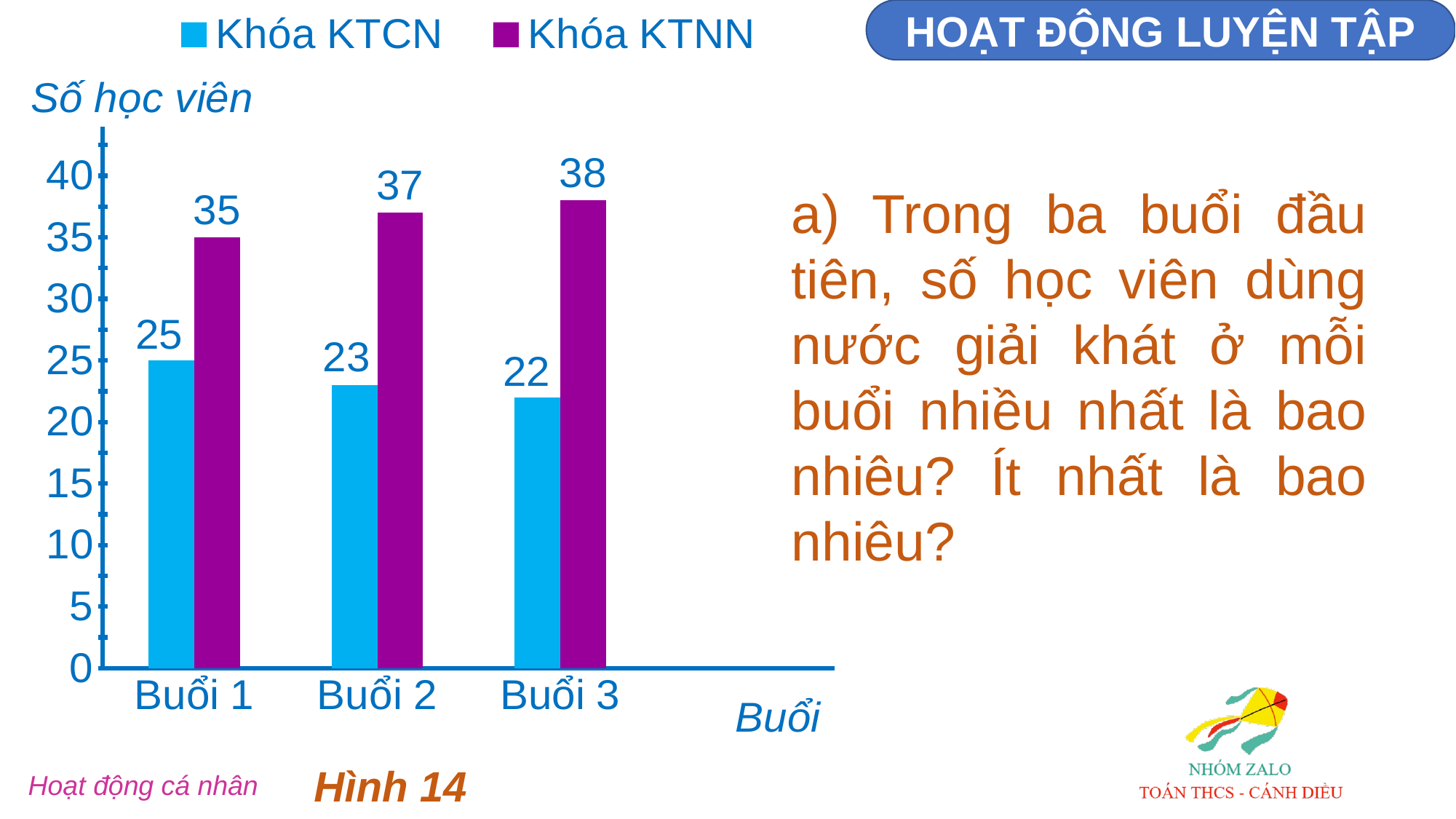
What is the label of the vertical axis? Số học viên What is the value for Khóa KTNN in Buổi 2? 37 What kind of chart is shown on the slide? bar chart Which is larger in Buổi 2: Khóa KTCN or Khóa KTNN? Khóa KTNN What is the value for Khóa KTCN in Buổi 3? 22 How many series does the legend list? 2 What is the value for Khóa KTCN in Buổi 1? 25 How many sessions (Buổi) are shown on the x axis? 3 Which session (Buổi) has the highest value for Khóa KTNN? Buổi 3 Which session (Buổi) has the lowest value for Khóa KTCN? Buổi 3 What is the difference between Khóa KTNN and Khóa KTCN in Buổi 1? 10 Is the value for Khóa KTNN in Buổi 3 greater or less than 30? greater